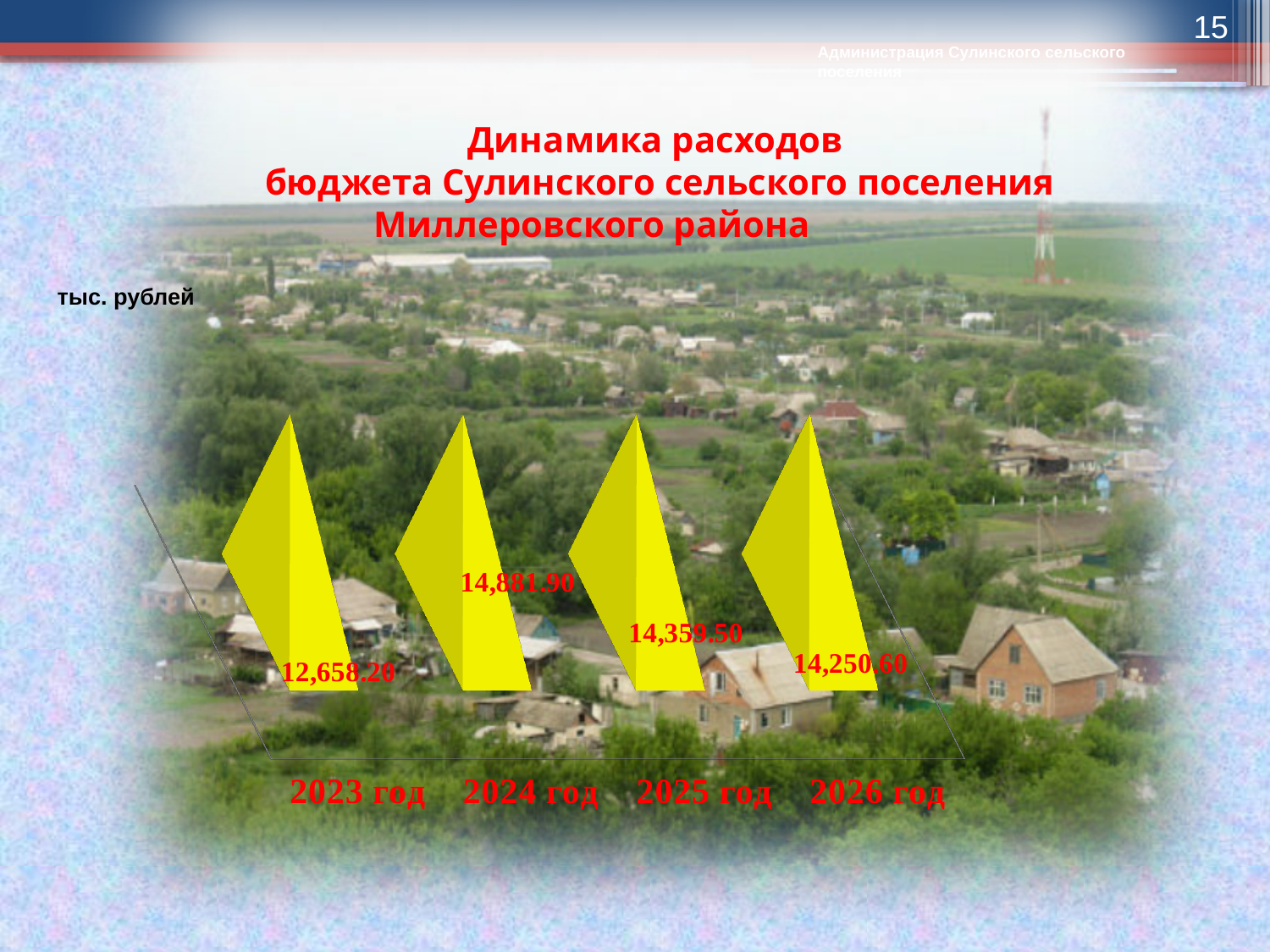
What is the value for 2026 год? 14,250.60 Which year has the highest value? 2024 год What kind of chart is shown on the slide? bar chart Which is larger, the value for 2025 год or the value for 2026 год? 2025 год What is the value for 2024 год? 14,881.90 What is the value for 2025 год? 14,359.50 What is the difference between the values for 2025 год and 2026 год? 108.90 Which year has the lowest value? 2023 год In what units are the values on the chart expressed? тыс. рублей What is the difference between the values for 2024 год and 2023 год? 2,223.70 How many years are shown on the chart? 4 What is the value for 2023 год? 12,658.20